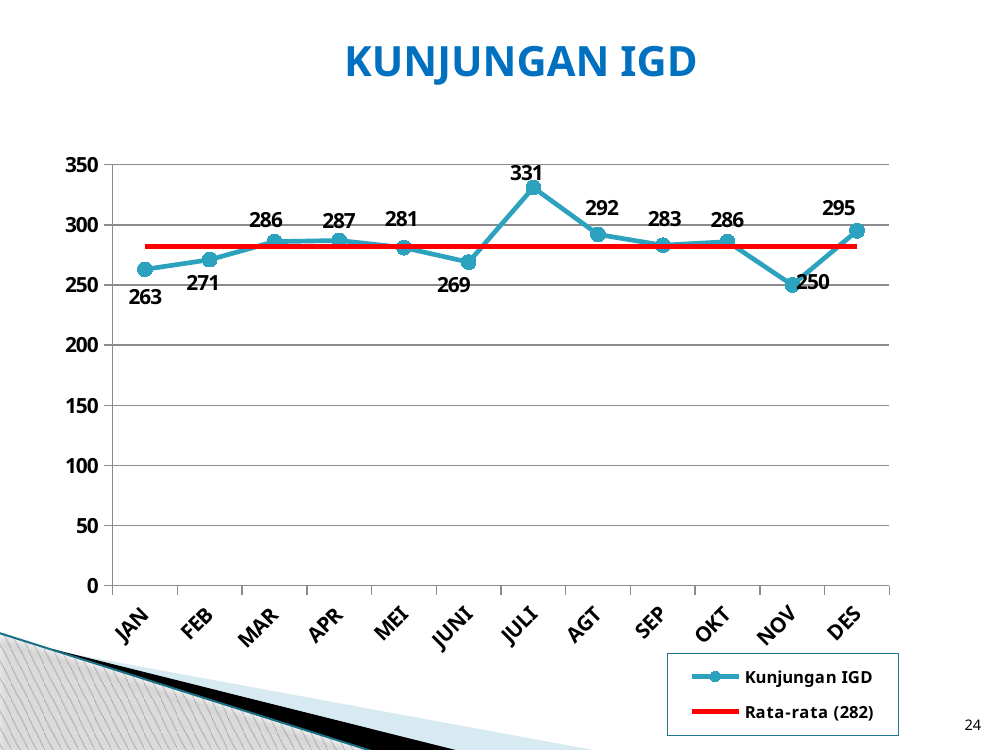
Which is larger, the value for DES or the value for AGT? DES Which month has the highest Kunjungan IGD value? JULI Is the value for JUNI greater or less than 300? less Which month has the lowest Kunjungan IGD value? NOV What is the value for JAN in the Kunjungan IGD chart? 263 How many months are plotted on the x axis of the chart? 12 What kind of chart is shown on the slide? line chart What is the value for NOV in the Kunjungan IGD chart? 250 What is the difference between the JULI and NOV values in the Kunjungan IGD chart? 81 How many series does the legend list? 2 What average value is given in the legend for the Rata-rata line? 282 What is the value for JULI in the Kunjungan IGD chart? 331